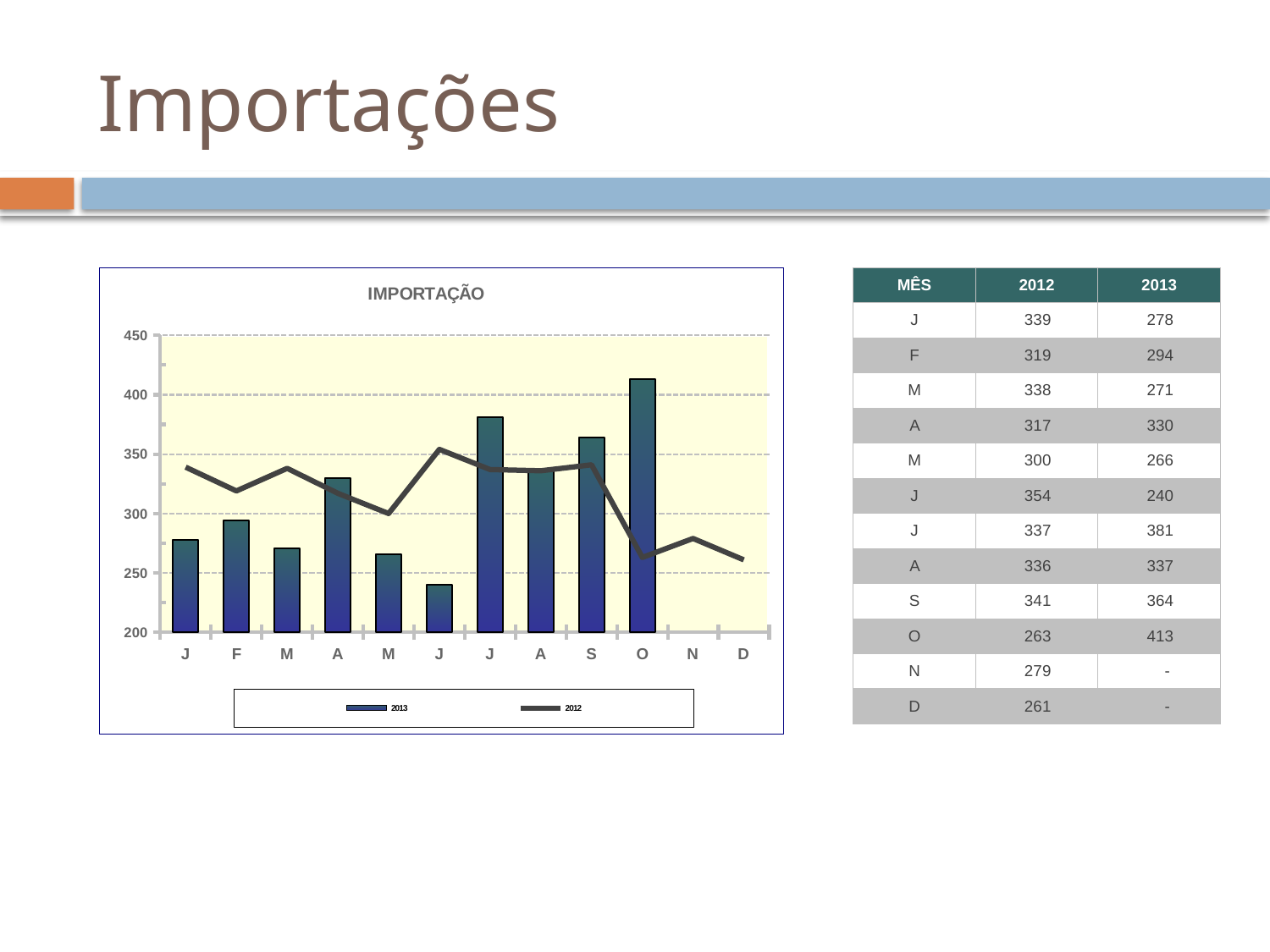
Is the 2013 value for month O greater or less than 400? greater Which month has the lowest 2013 bar? J (June) What is the 2012 value for month F? 319 What is the 2013 value for month O? 413 What kind of chart is shown on the slide? bar and line chart What is the difference between the 2013 and 2012 values for month O? 150 What is the title of the chart? IMPORTAÇÃO For month S, which is larger, the 2013 value or the 2012 value? 2013 How many months have a 2013 bar plotted? 10 Which month has the highest 2013 bar? O What is the 2012 value for month N? 279 How many series does the legend of the IMPORTAÇÃO chart list? 2